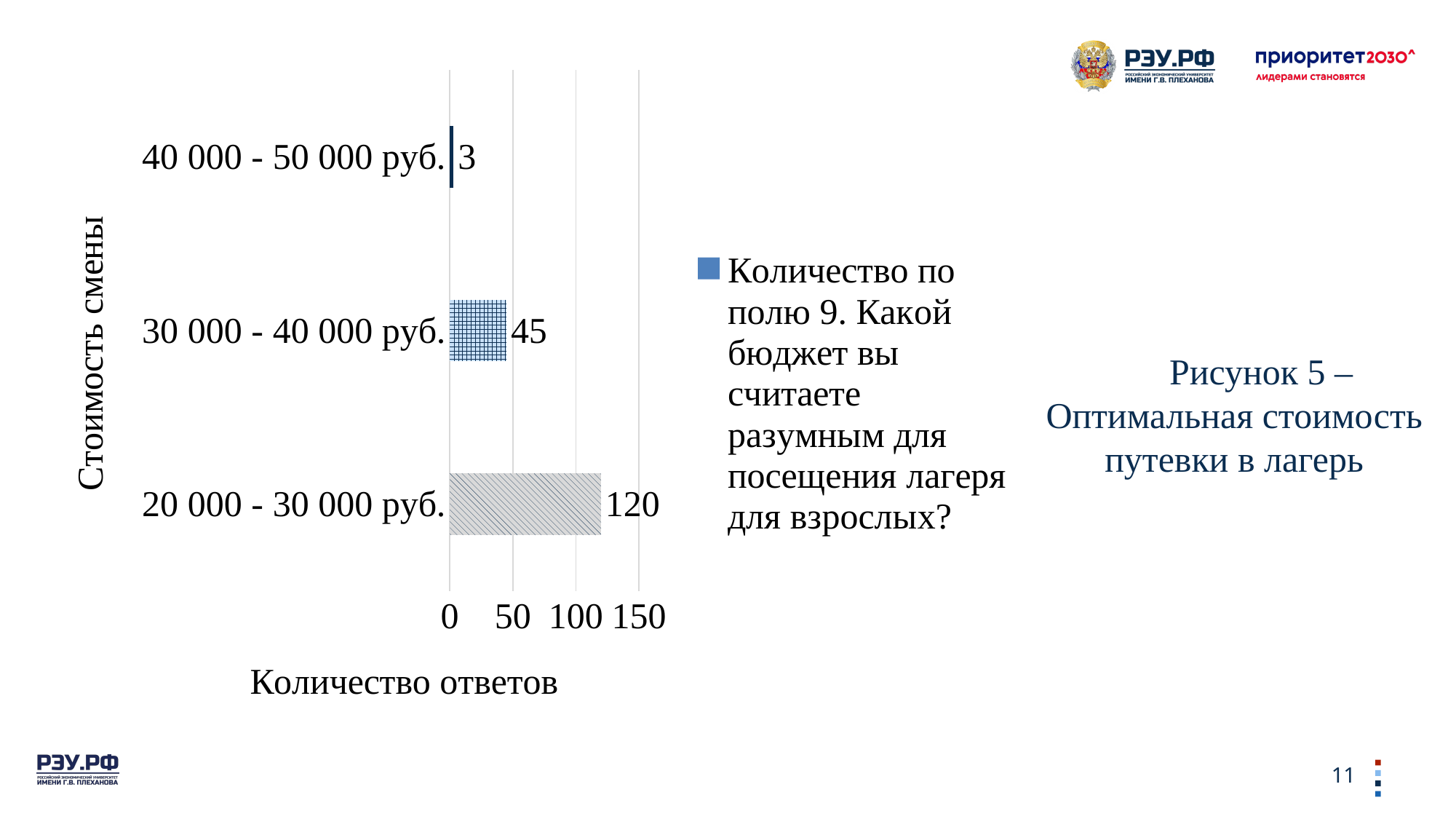
How many responses are shown for the category "30 000 - 40 000 руб."? 45 How many responses are shown for the category "20 000 - 30 000 руб."? 120 What is the difference in responses between "20 000 - 30 000 руб." and "30 000 - 40 000 руб."? 75 What type of chart is shown on the slide? Bar chart What is the label of the horizontal axis of the chart? Количество ответов How many responses are shown for the category "40 000 - 50 000 руб."? 3 What is the difference in responses between "30 000 - 40 000 руб." and "40 000 - 50 000 руб."? 42 Is the value for "20 000 - 30 000 руб." greater or less than 100? greater Which price range received the most responses? 20 000 - 30 000 руб. How many price-range categories are shown in the chart? 3 Which has more responses: "30 000 - 40 000 руб." or "40 000 - 50 000 руб."? 30 000 - 40 000 руб. Which price range received the fewest responses? 40 000 - 50 000 руб.